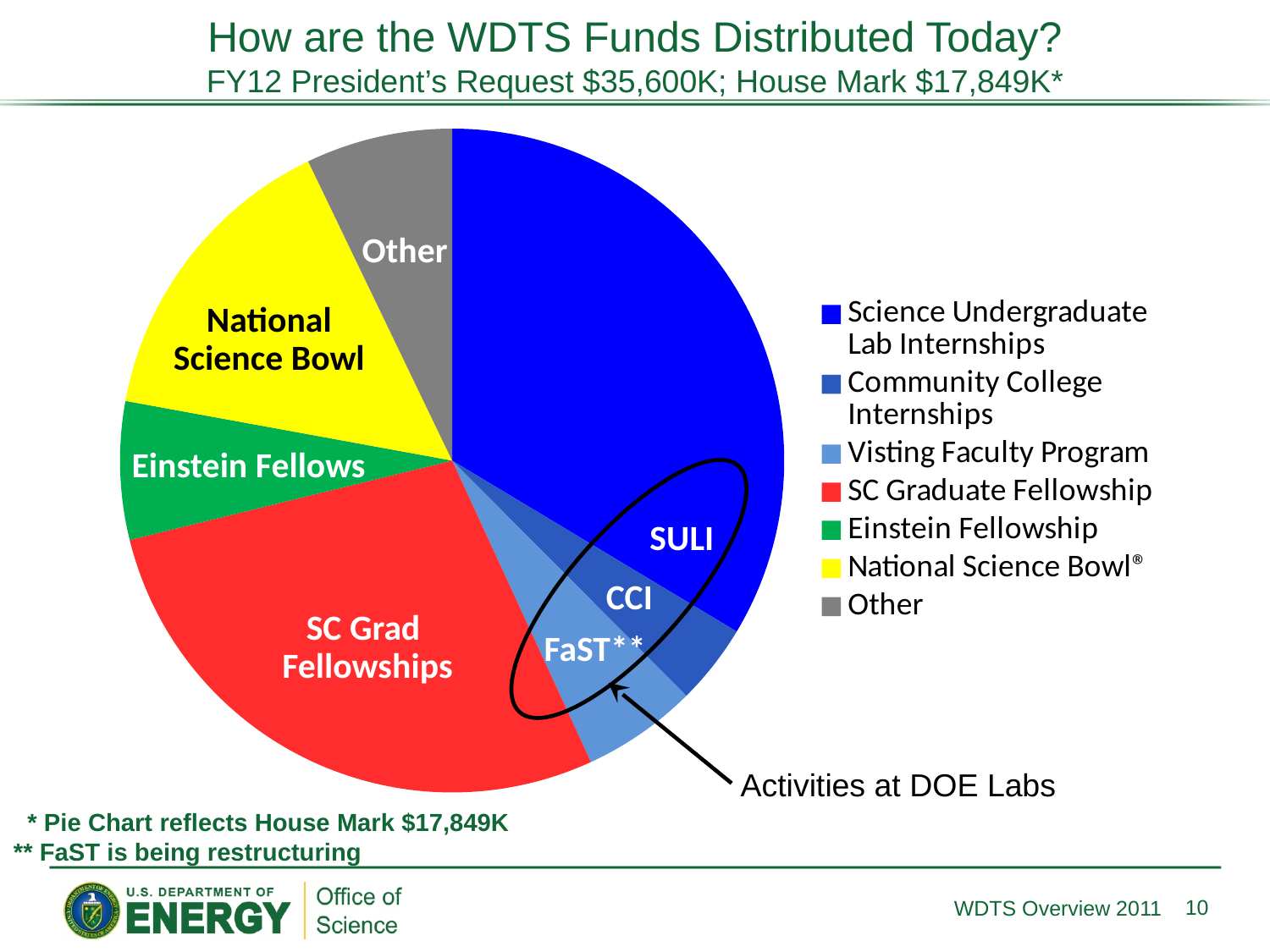
How many entries does the legend of the pie chart list? 7 Which is larger in the pie chart, the SULI slice or the SC Grad Fellowships slice? SULI Which is larger in the pie chart, the SC Grad Fellowships slice or the National Science Bowl slice? SC Grad Fellowships What kind of chart is shown on the slide? pie chart How many slices does the pie chart have? 7 What is the title of the slide containing the pie chart? How are the WDTS Funds Distributed Today? Which slice of the pie chart is the largest? Science Undergraduate Lab Internships (SULI) Which is larger in the pie chart, the National Science Bowl slice or the Einstein Fellows slice? National Science Bowl What colour is the SC Graduate Fellowship slice in the pie chart? red